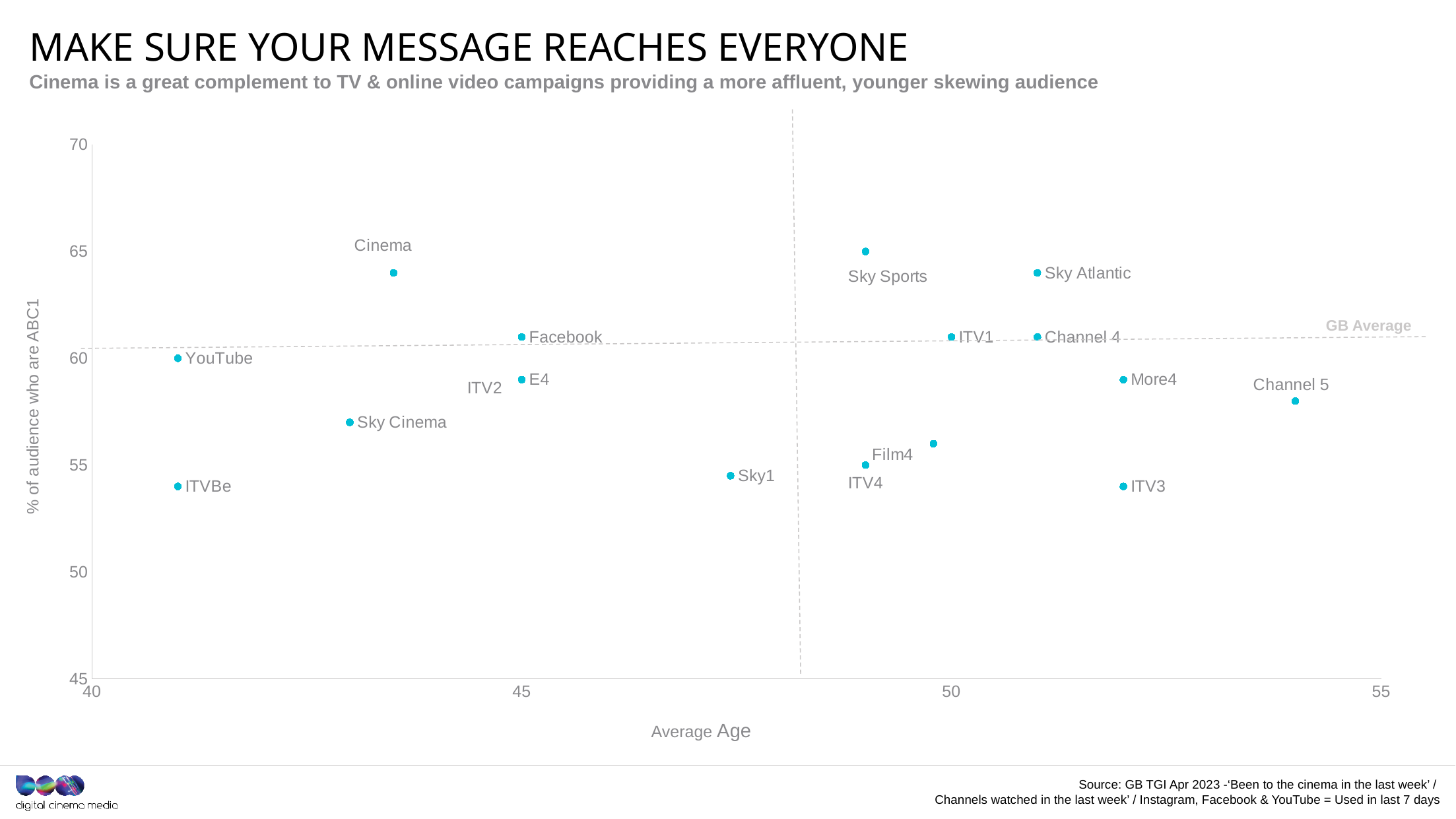
How many labelled data points are plotted on the chart? 17 Is the average age for Channel 5 greater or less than 50? greater Which point has the highest average age on the chart? Channel 5 What is the label on the horizontal dashed line across the chart? GB Average Is the percentage of audience who are ABC1 for ITVBe greater or less than 55? less Which point has the highest percentage of audience who are ABC1? Sky Sports What kind of chart is shown on the slide? scatter chart Is the percentage of audience who are ABC1 for Sky Cinema greater or less than 60? less Which has a higher percentage of audience who are ABC1, Cinema or Sky Cinema? Cinema Which has a higher average age, Cinema or Channel 5? Channel 5